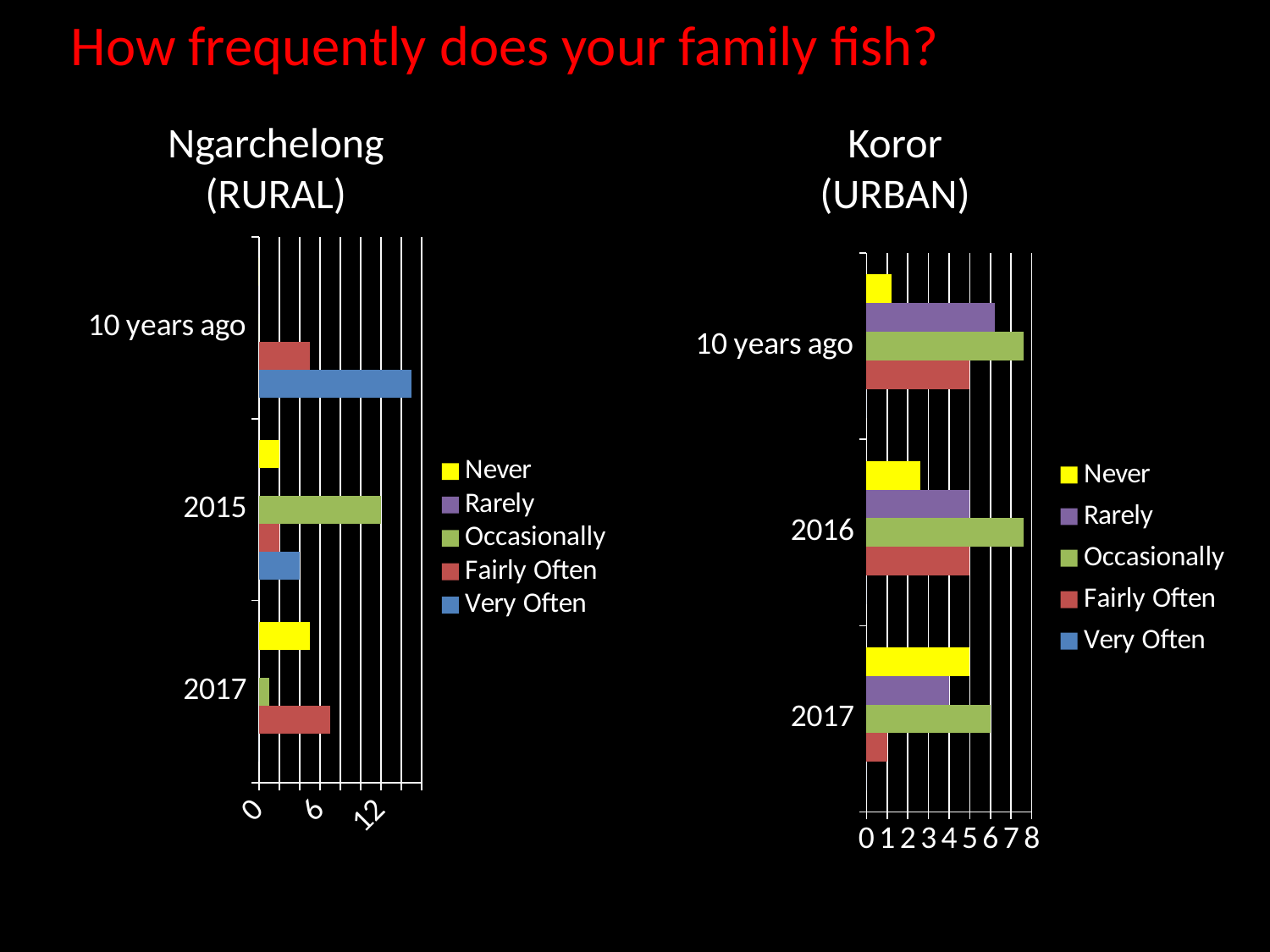
In the Koror (URBAN) chart, does the Never value rise or fall from 10 years ago to 2017? rise In the Ngarchelong (RURAL) chart, is the Very Often value for 10 years ago greater or less than 12? greater In the Ngarchelong (RURAL) chart, is the Occasionally value for 2015 greater or less than 6? greater How many categories are shown on the Ngarchelong (RURAL) chart? 3 In the Koror (URBAN) chart, is the Fairly Often value for 2017 greater or less than 2? less How many series does the legend of the Koror (URBAN) chart list? 5 In the Koror (URBAN) chart, which series has the longest bar for 2017? Occasionally What kind of chart is the Ngarchelong (RURAL) chart? bar chart In the Koror (URBAN) chart, which is larger: the Never value for 10 years ago or the Never value for 2017? 2017 In the Ngarchelong (RURAL) chart, which series has the longest bar for 10 years ago? Very Often In the Koror (URBAN) chart, which legend series has no visible bars? Very Often